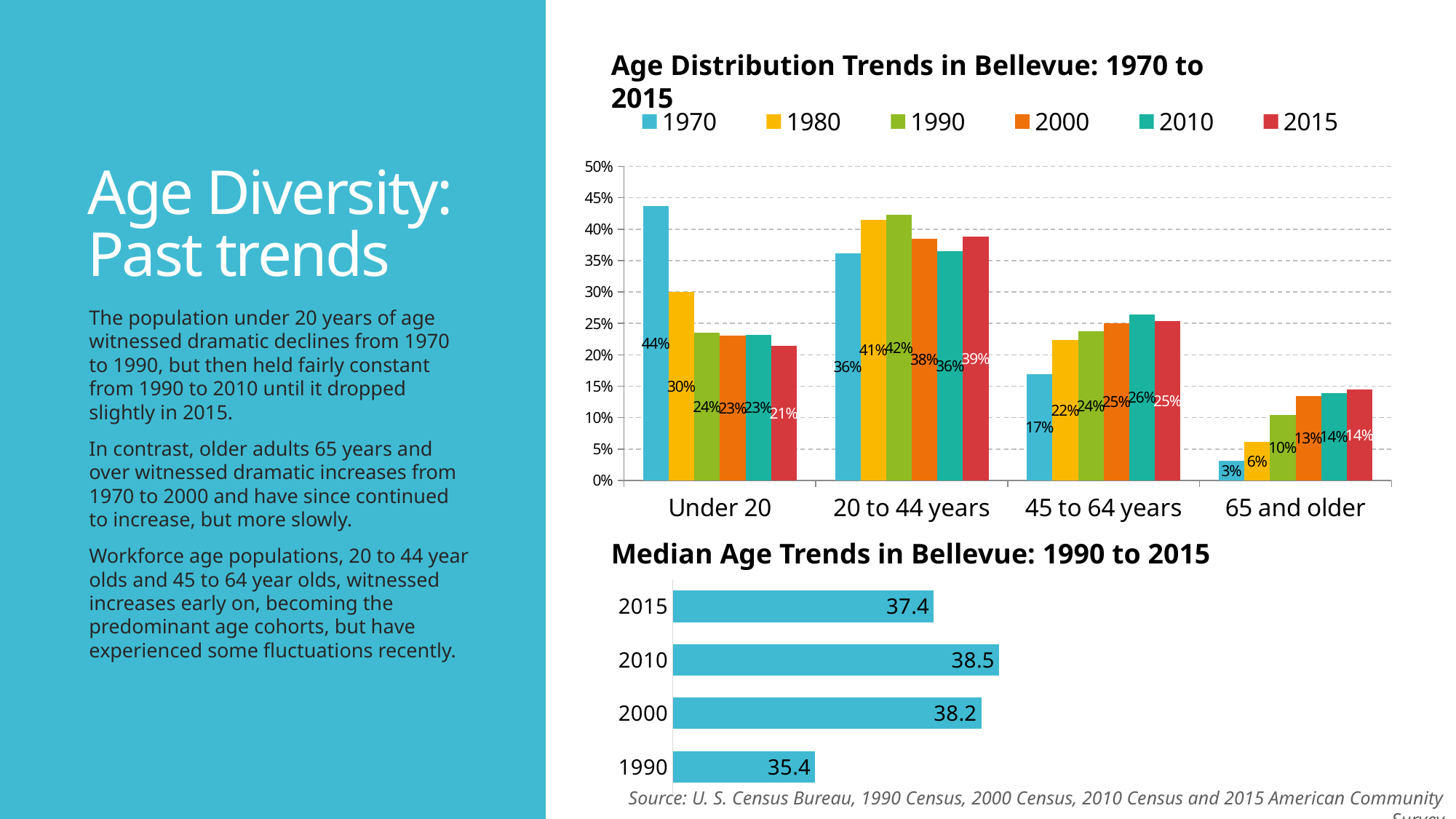
In the 'Age Distribution Trends in Bellevue: 1970 to 2015' chart, what is the value for 65 and older in 2015? 14% In the 'Median Age Trends in Bellevue: 1990 to 2015' chart, what is the median age for 2010? 38.5 In the 'Age Distribution Trends in Bellevue: 1970 to 2015' chart, how many series does the legend list? 6 In the 'Age Distribution Trends in Bellevue: 1970 to 2015' chart, what is the value for 20 to 44 years in 1990? 42% In the 'Age Distribution Trends in Bellevue: 1970 to 2015' chart, which year has the lowest value for 65 and older? 1970 In the 'Age Distribution Trends in Bellevue: 1970 to 2015' chart, what is the value for Under 20 in 1970? 44% In the 'Median Age Trends in Bellevue: 1990 to 2015' chart, what is the difference between the median ages for 2010 and 1990? 3.1 In the 'Age Distribution Trends in Bellevue: 1970 to 2015' chart, what is the difference between the Under 20 values for 1970 and 2015? 23% In the 'Median Age Trends in Bellevue: 1990 to 2015' chart, which year has the lowest median age? 1990 What kind of chart is the 'Median Age Trends in Bellevue: 1990 to 2015' chart? bar chart In the 'Age Distribution Trends in Bellevue: 1970 to 2015' chart, do the values for 65 and older rise or fall from 1970 to 2015? rise In the 'Age Distribution Trends in Bellevue: 1970 to 2015' chart, how many age categories are shown on the x axis? 4